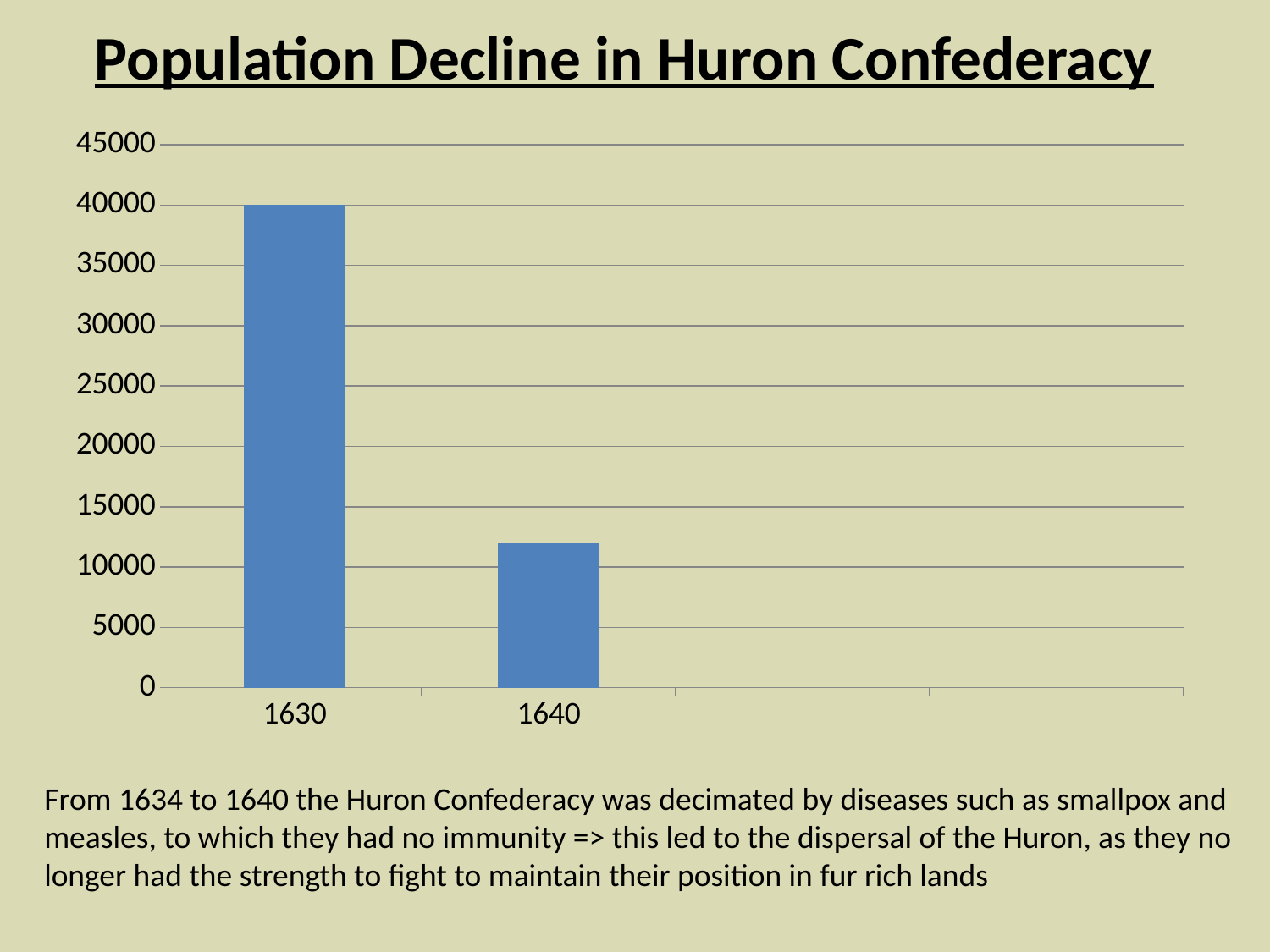
How many bars are plotted in the chart? 2 Is the value for 1640 greater or less than 10000? greater Is the value for 1640 greater or less than 15000? less What kind of chart is shown on the slide? bar chart What is the title of the chart on the slide? Population Decline in Huron Confederacy Which year has the highest population value in the chart? 1630 Which is larger, the value for 1630 or the value for 1640? 1630 Do the values rise or fall from 1630 to 1640? fall Which year has the lowest population value in the chart? 1640 What is the population value shown for 1630? 40000 Is the value for 1630 greater or less than 35000? greater What is the highest value shown on the vertical axis of the chart? 45000